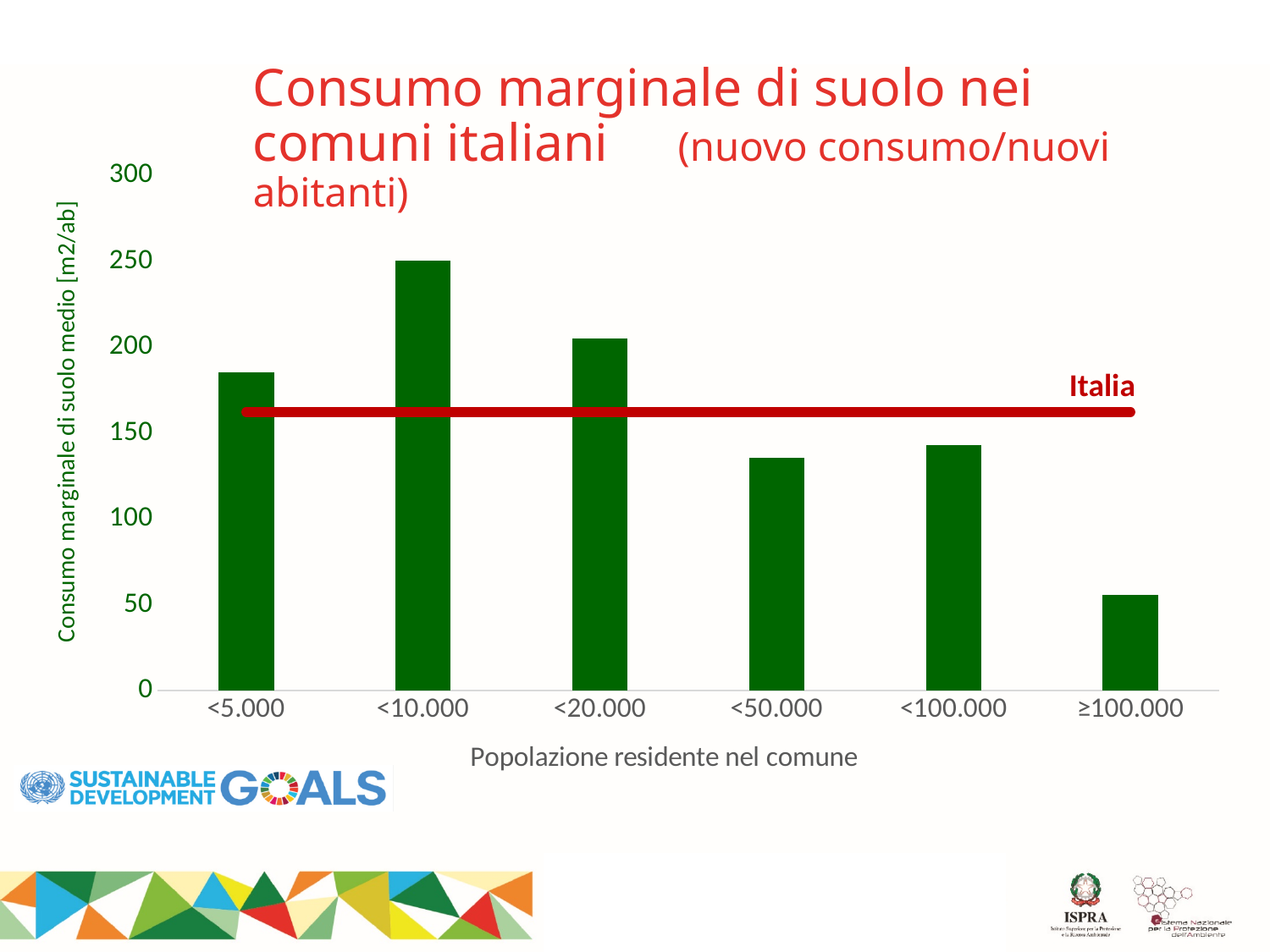
Which population category has the highest marginal soil consumption? <10.000 What label is given to the horizontal red reference line? Italia What is the x-axis title of the chart? Popolazione residente nel comune Which is larger, the value for <10.000 or the value for <20.000? <10.000 Is the value for <50.000 greater or less than 150? less Is the value for <10.000 greater or less than 200? greater Which population category has the lowest marginal soil consumption? ≥100.000 Which is larger, the value for <5.000 or the value for <50.000? <5.000 How many population categories are shown on the x axis? 6 Is the value for ≥100.000 greater or less than 100? less What kind of chart is shown on the slide? bar chart